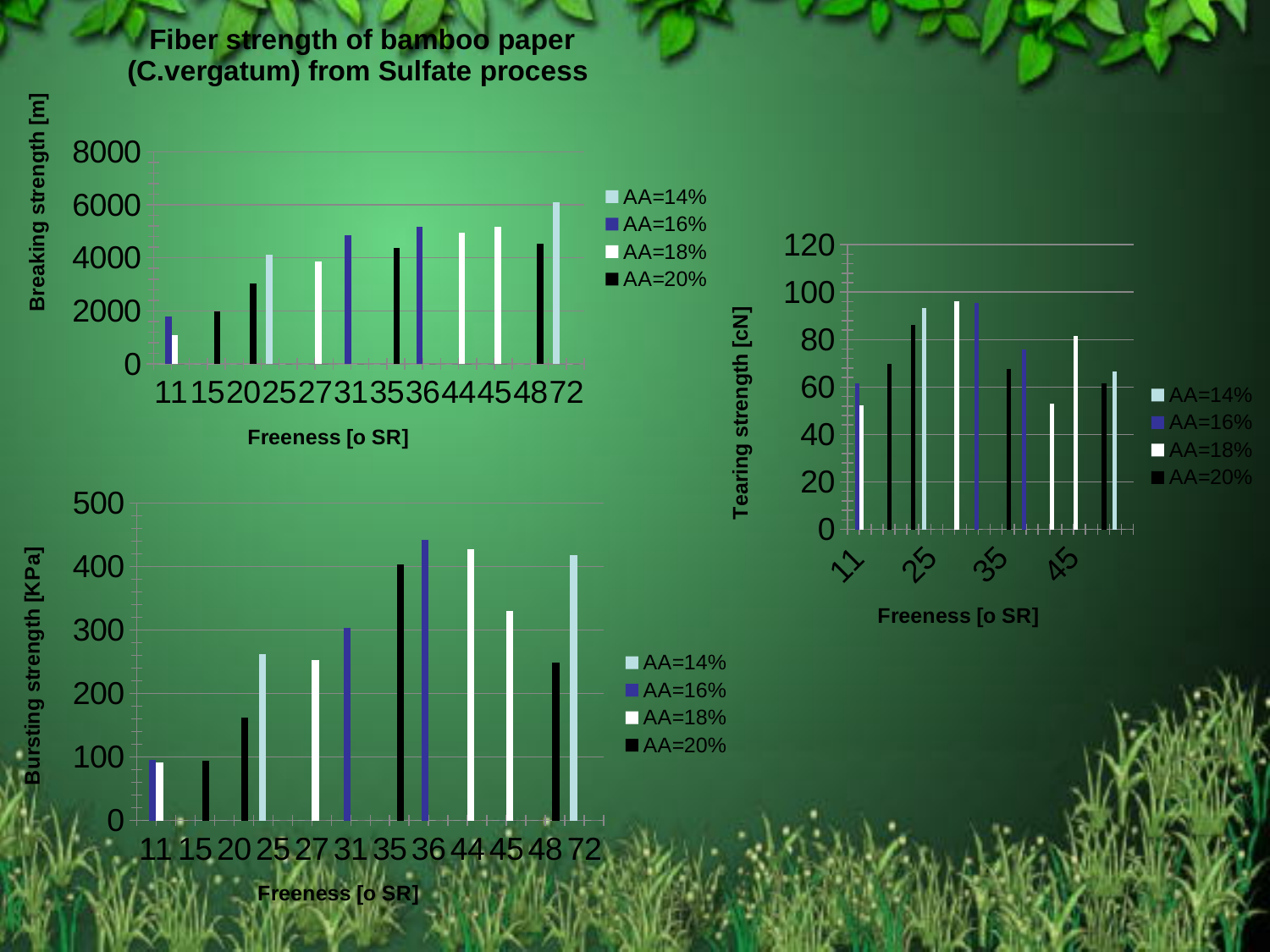
How many freeness categories are shown on the x axis of the Breaking strength chart? 12 In the Breaking strength chart, is the value for AA=16% at freeness 11 greater or less than 2000? less In the Tearing strength chart, is the value for AA=20% at freeness 35 greater or less than 80? less What kind of chart is the Breaking strength chart at the top left of the slide? bar chart In the Breaking strength chart, is the value for AA=16% at freeness 36 greater or less than 4000? greater In the Breaking strength chart, which freeness category has the highest bar? 72 What is the y-axis label of the chart on the right side of the slide? Tearing strength [cN] How many series does the legend of the Bursting strength chart list? 4 In the Breaking strength chart, which is larger: the bar at freeness 72 or the bar for AA=16% at freeness 11? 72